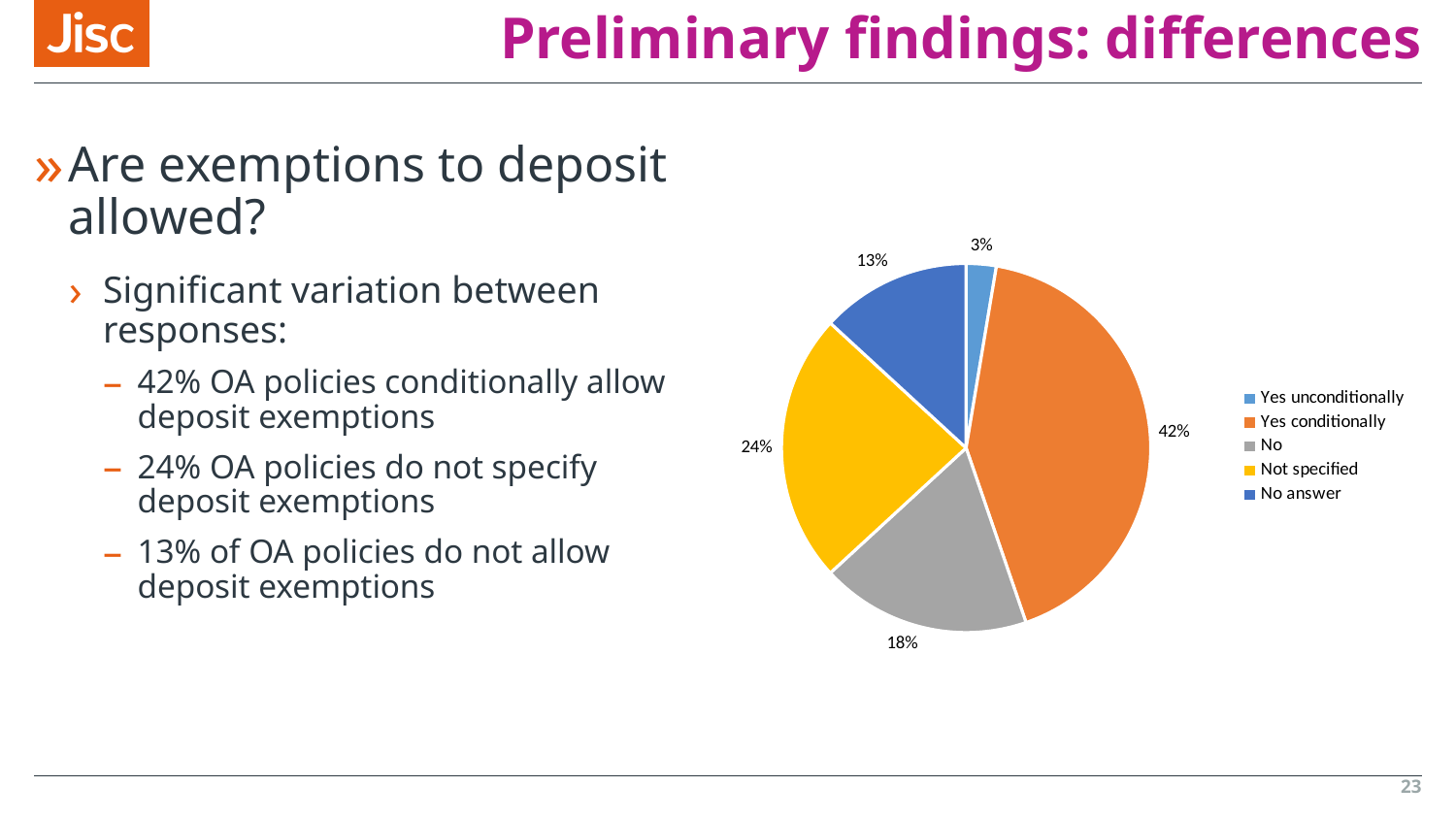
What percentage is shown for 'No answer'? 13% What colour is the slice for 'Not specified'? Yellow What percentage is shown for 'No'? 18% What share of the pie does 'Yes conditionally' represent? 42% What percentage is shown for 'Not specified'? 24% What is the difference in percentage points between 'Yes conditionally' and 'Not specified'? 18 Which is larger, the slice for 'No' or the slice for 'No answer'? No What type of chart is shown on the slide? Pie chart How many categories does the pie chart show? 5 Which category has the largest slice of the pie? Yes conditionally Which category has the smallest slice of the pie? Yes unconditionally What percentage is shown for 'Yes unconditionally'? 3%